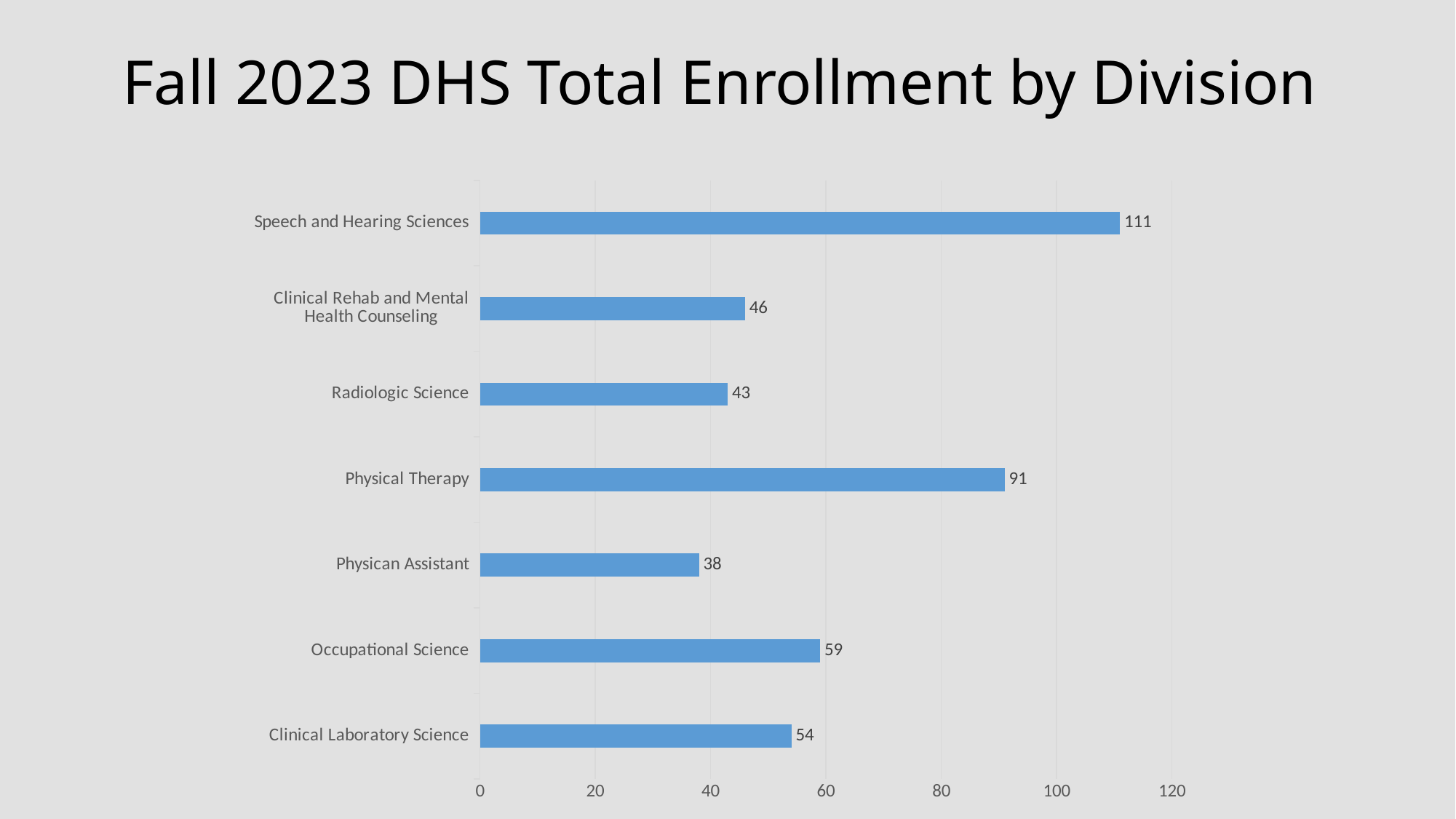
What is the enrollment for Physical Therapy? 91 What is the enrollment for Clinical Rehab and Mental Health Counseling? 46 What kind of chart is shown on the slide? Bar chart Which division has the highest enrollment? Speech and Hearing Sciences What is the difference in enrollment between Occupational Science and Clinical Laboratory Science? 5 What is the difference in enrollment between Speech and Hearing Sciences and Physical Therapy? 20 What is the enrollment for Speech and Hearing Sciences? 111 How many divisions are shown in the chart? 7 Is the value for Physical Therapy greater or less than 80? greater Which has higher enrollment, Radiologic Science or Occupational Science? Occupational Science Which division has the lowest enrollment? Physican Assistant What is the enrollment for Clinical Laboratory Science? 54